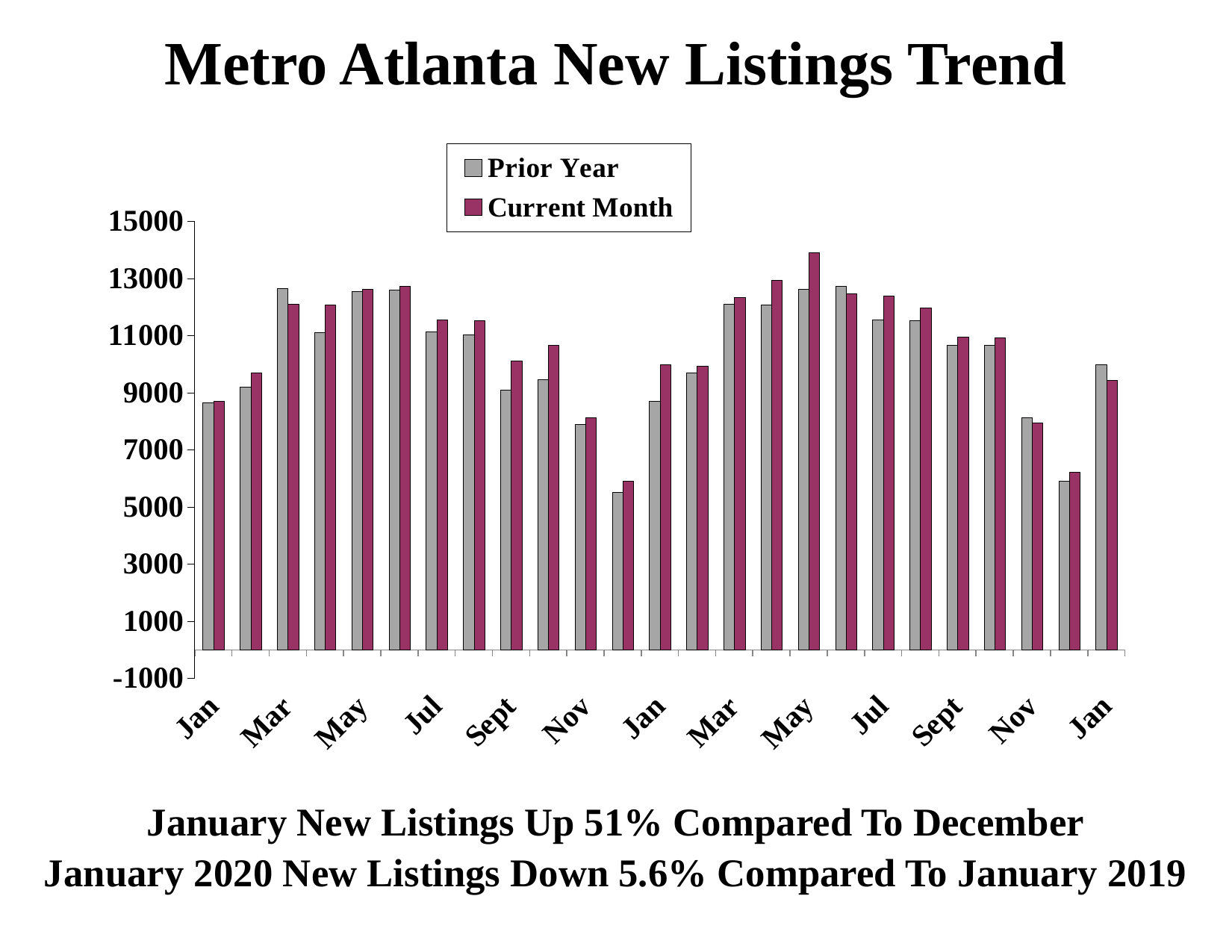
Which series is shown in the darker (maroon) bars? Current Month For the last Jan, which is larger: the Prior Year value or the Current Month value? Prior Year In which labeled month does the Current Month series reach its highest value? the second May Is the Current Month value for the first Nov greater or less than 9000? less How many series does the legend list? 2 Do the Current Month values rise or fall from the second May to the second Nov? fall What kind of chart is shown on the slide? bar chart Is the Current Month value for the last Jan greater or less than 10000? less How many month labels are shown along the x axis? 13 Is the Prior Year value for the second Nov greater or less than 9000? less What is the title of the chart? Metro Atlanta New Listings Trend